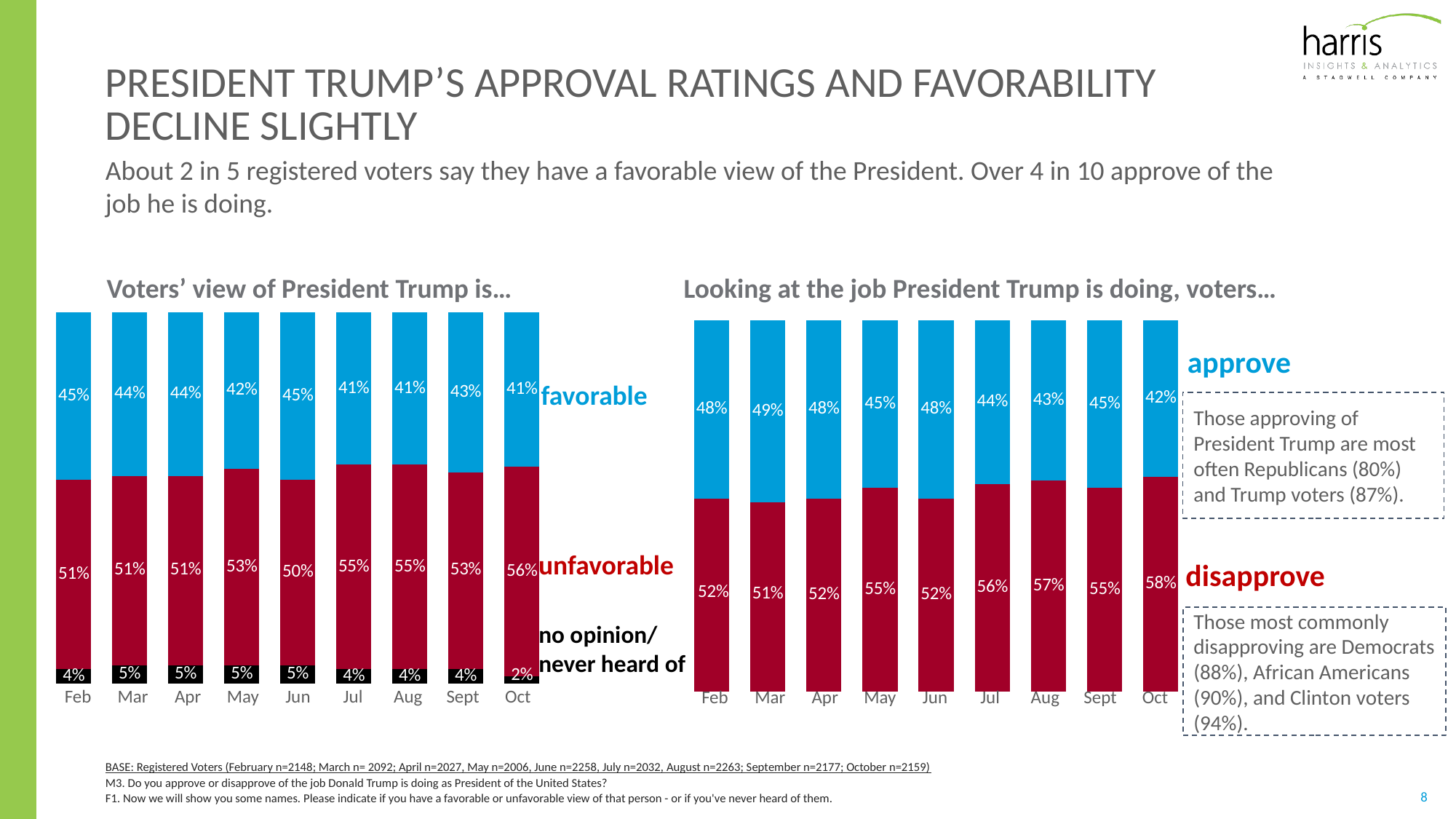
In the chart 'Voters' view of President Trump is...', what percentage of voters had a favorable view in Oct? 41% In the chart 'Voters' view of President Trump is...', what is the 'no opinion/never heard of' value for Oct? 2% In the chart 'Looking at the job President Trump is doing, voters...', which month has the highest disapprove value? Oct In the chart 'Voters' view of President Trump is...', what percentage of voters had an unfavorable view in Jul? 55% In the chart 'Looking at the job President Trump is doing, voters...', is the approve value in Feb larger or smaller than the approve value in Aug? larger In the chart 'Voters' view of President Trump is...', what is the difference between the unfavorable and favorable values in Oct? 15% In the chart 'Looking at the job President Trump is doing, voters...', which month has the lowest approve value? Oct In the chart 'Looking at the job President Trump is doing, voters...', what percentage disapproved in Oct? 58% In the chart 'Looking at the job President Trump is doing, voters...', what percentage approved in Mar? 49% What kind of chart is 'Looking at the job President Trump is doing, voters...'? Stacked bar chart How many months are shown on the x axis of the chart 'Voters' view of President Trump is...'? 9 How many series are shown in the chart 'Voters' view of President Trump is...'? 3